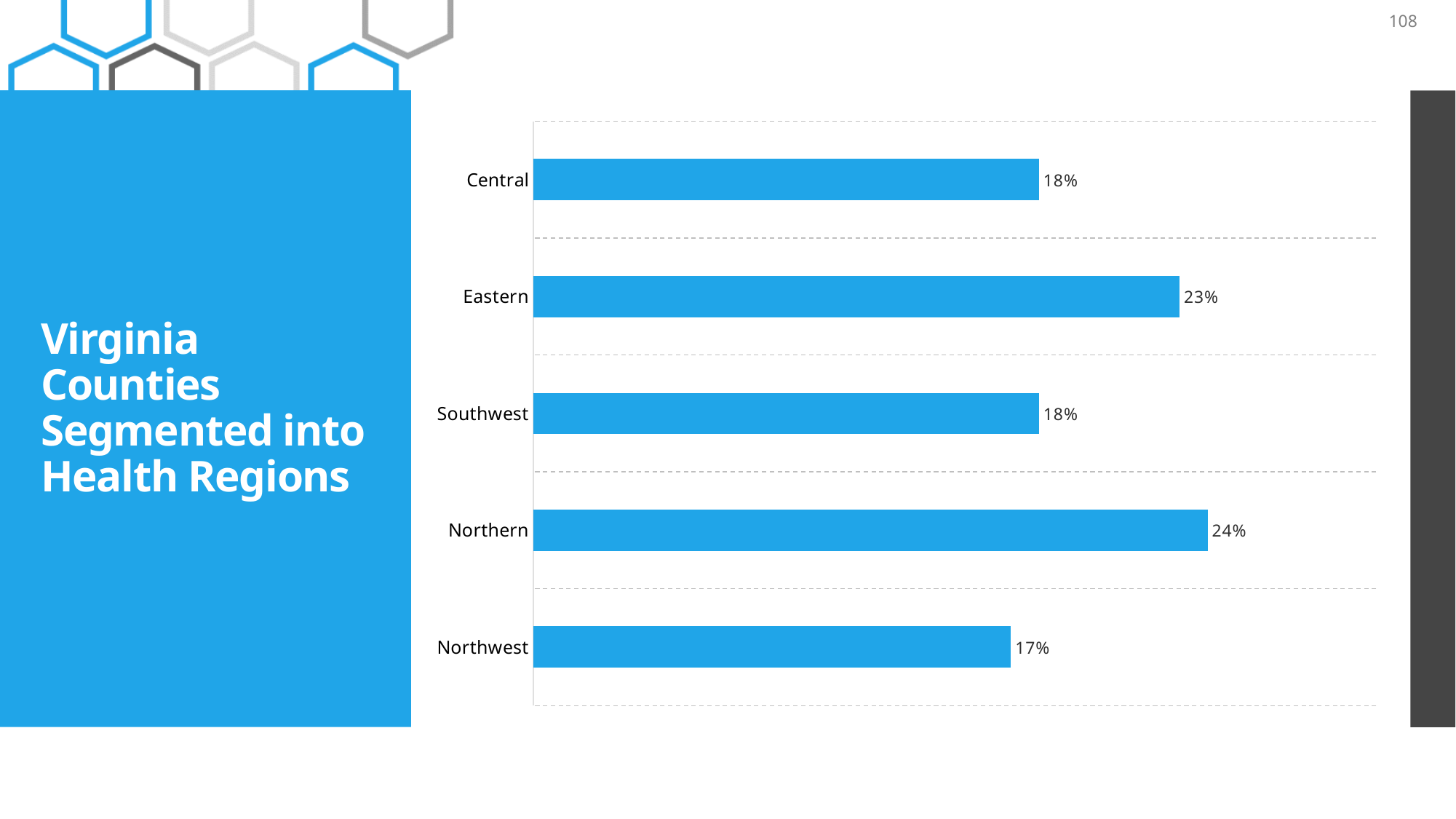
How many regions are shown in the chart? 5 What is the value for Eastern? 23% What is the title text on the left of the slide? Virginia Counties Segmented into Health Regions Which is larger, the value for Eastern or the value for Southwest? Eastern What is the value for Northwest? 17% What is the value for Northern? 24% Which region has the lowest value? Northwest What is the difference between the values for Northern and Northwest? 7% What is the value for Central? 18% What kind of chart is shown on the slide? Bar chart What is the difference between the values for Eastern and Central? 5% Which region has the highest value? Northern